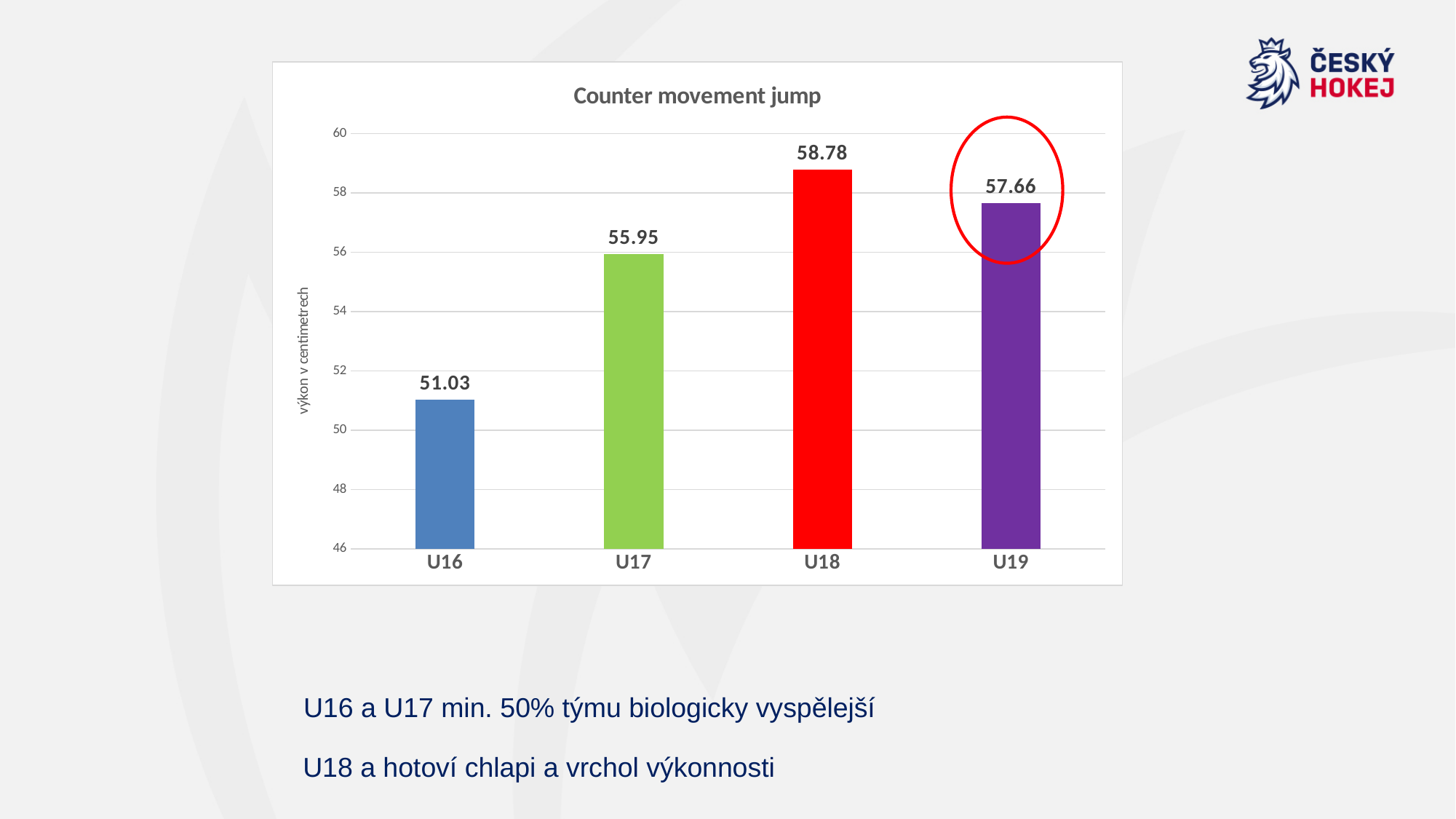
Which category has the highest value? U18 What is the value for U18? 58.78 What is the difference between the values for U18 and U19? 1.12 Which category has the lowest value? U16 Which is larger, the value for U17 or the value for U19? U19 What is the value for U17? 55.95 What kind of chart is this? Bar chart What is the difference between the values for U17 and U16? 4.92 How many categories are shown on the x axis? 4 What is the value for U19? 57.66 What is the title of the chart? Counter movement jump What is the value for U16? 51.03